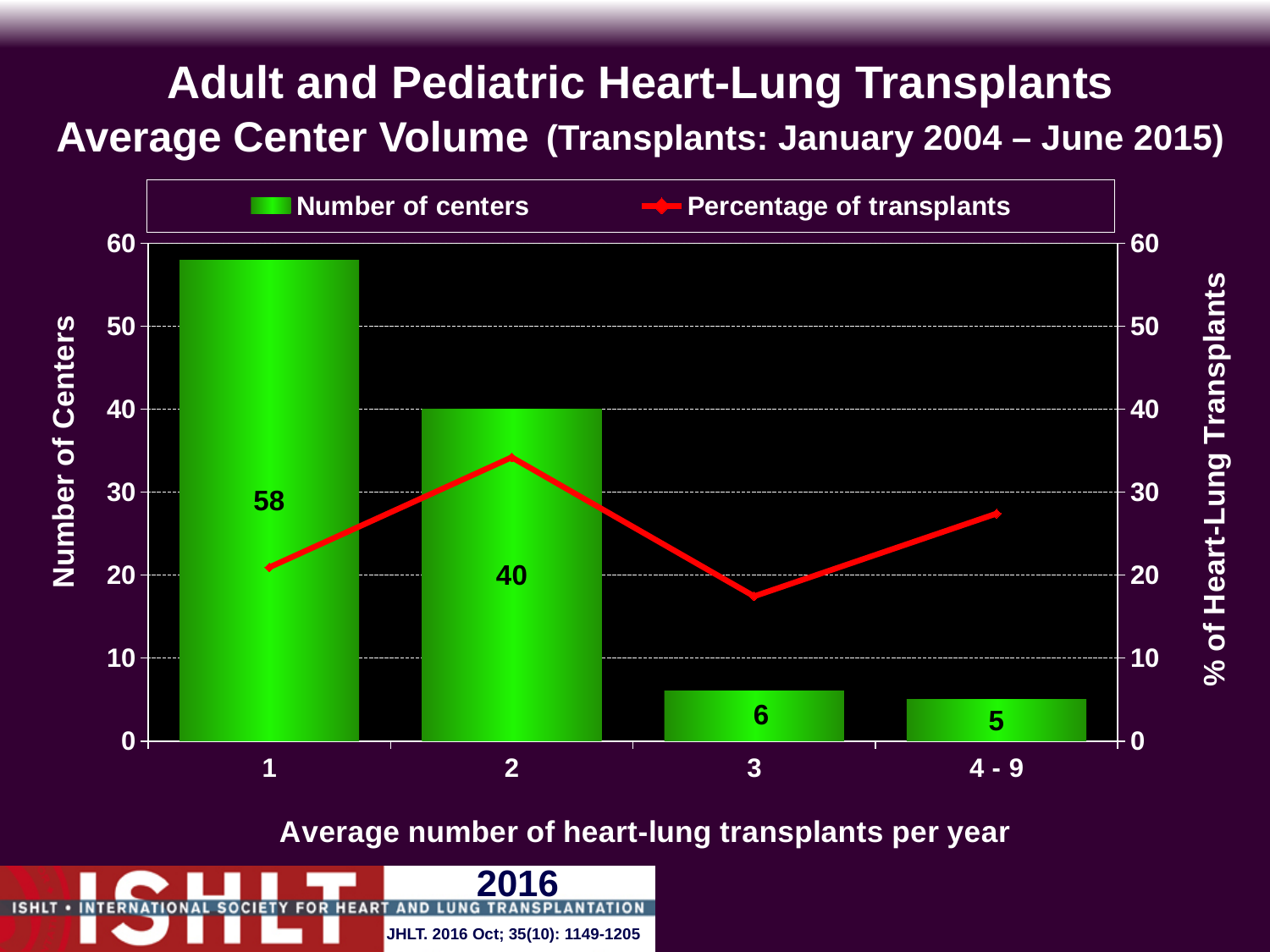
Is the percentage of transplants for category 2 greater or less than 30? greater How many categories are shown on the x axis? 4 Which category has the highest number of centers? 1 Which has more centers, category 2 or category 3? 2 Which category has the lowest number of centers? 4 - 9 What is the label of the x axis? Average number of heart-lung transplants per year What is the number of centers for the category 2? 40 Is the percentage of transplants for category 3 greater or less than 20? less What is the number of centers for the category 1 (average number of heart-lung transplants per year)? 58 What is the difference in number of centers between category 1 and category 2? 18 What is the number of centers for the category 4 - 9? 5 How many series does the legend list? 2